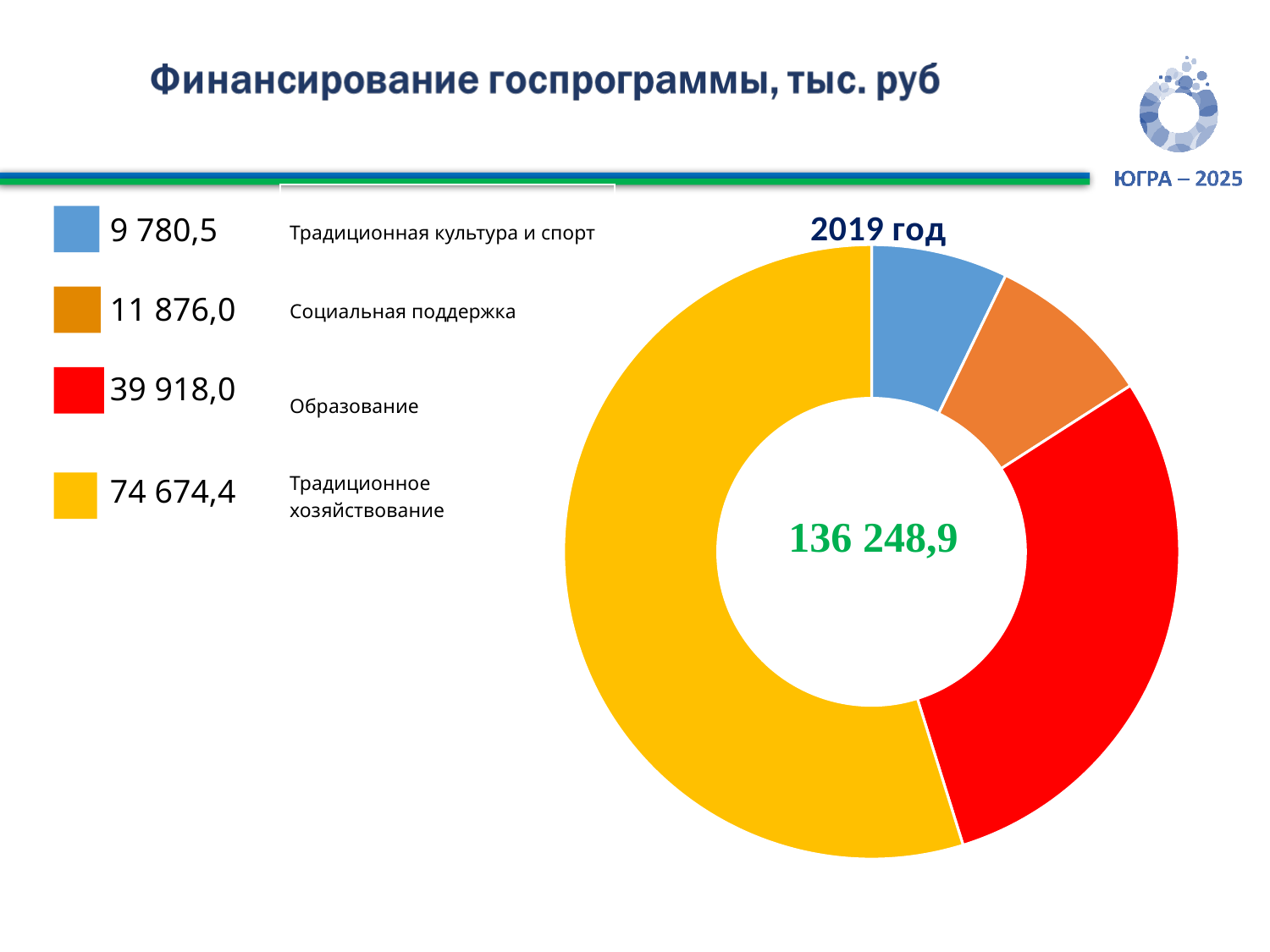
What is the value for Традиционное хозяйствование? 74 674,4 What is the value for Образование? 39 918,0 Which category has the smallest value? Традиционная культура и спорт What is the total value shown in the centre of the chart? 136 248,9 Which category has the largest value? Традиционное хозяйствование What is the value for Социальная поддержка? 11 876,0 What is the difference between Традиционное хозяйствование and Образование? 34 756,4 How many categories does the chart show? 4 What type of chart is shown on the slide? Pie (donut) chart What is the value for Традиционная культура и спорт? 9 780,5 Which year does the chart refer to, according to its title? 2019 год Which is larger: Социальная поддержка or Традиционная культура и спорт? Социальная поддержка